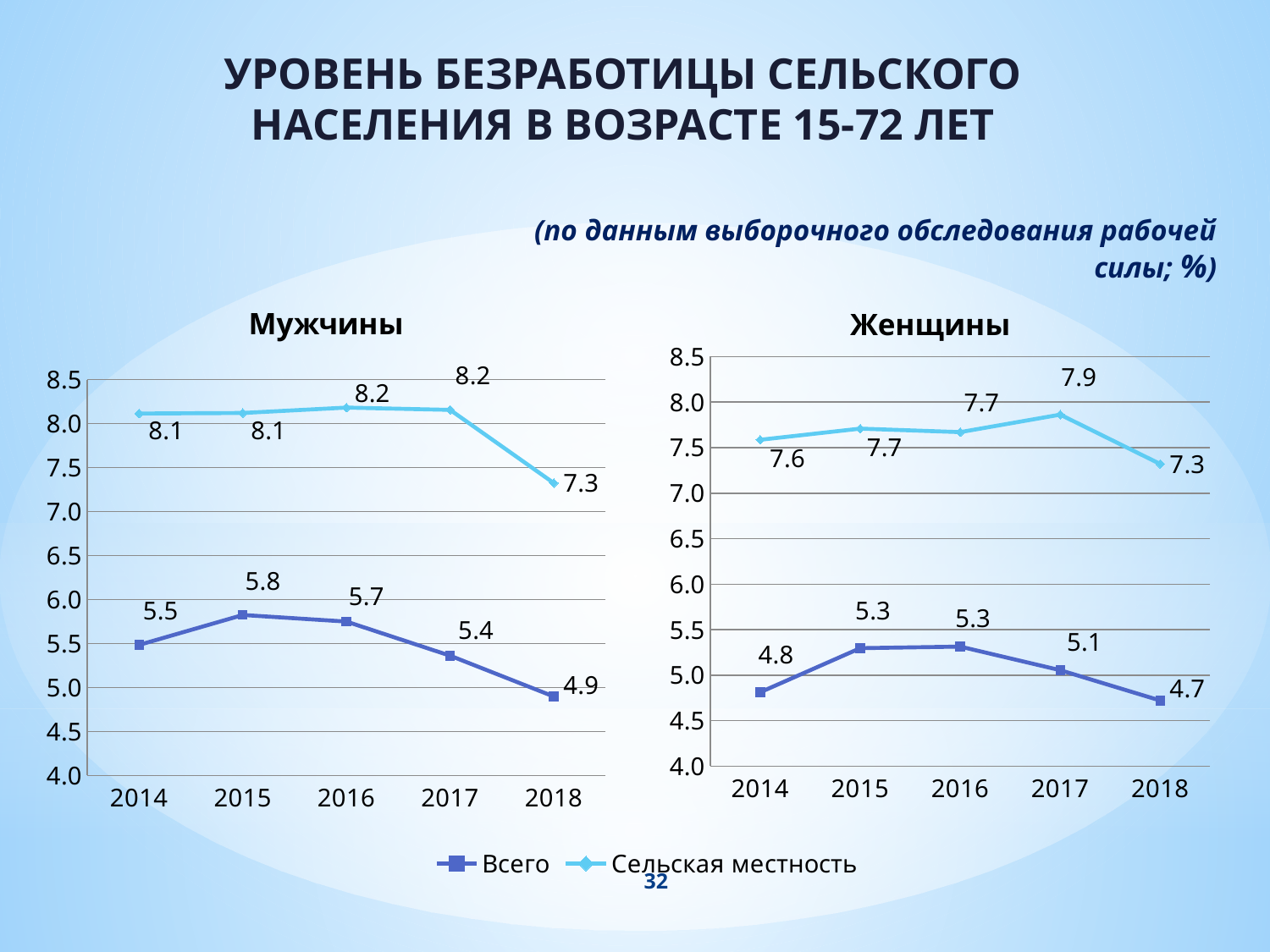
In the "Женщины" chart, in which year is the "Сельская местность" series lowest? 2018 In the "Мужчины" chart, in which year is the "Всего" series highest? 2015 In the "Мужчины" chart, what is the value for "Сельская местность" in 2018? 7.3 In the "Женщины" chart, what is the value for "Сельская местность" in 2017? 7.9 In the "Мужчины" chart, what is the value for "Всего" in 2015? 5.8 In the "Женщины" chart, what is the value for "Всего" in 2014? 4.8 How many years are shown on the x axis of the "Женщины" chart? 5 In the "Мужчины" chart, does the "Всего" series rise or fall from 2015 to 2018? Fall How many series does the legend list? 2 What kind of chart is the "Мужчины" chart? Line chart In the "Женщины" chart, which is larger in 2016: "Сельская местность" or "Всего"? Сельская местность In the "Мужчины" chart, what is the difference between "Сельская местность" and "Всего" in 2018? 2.4